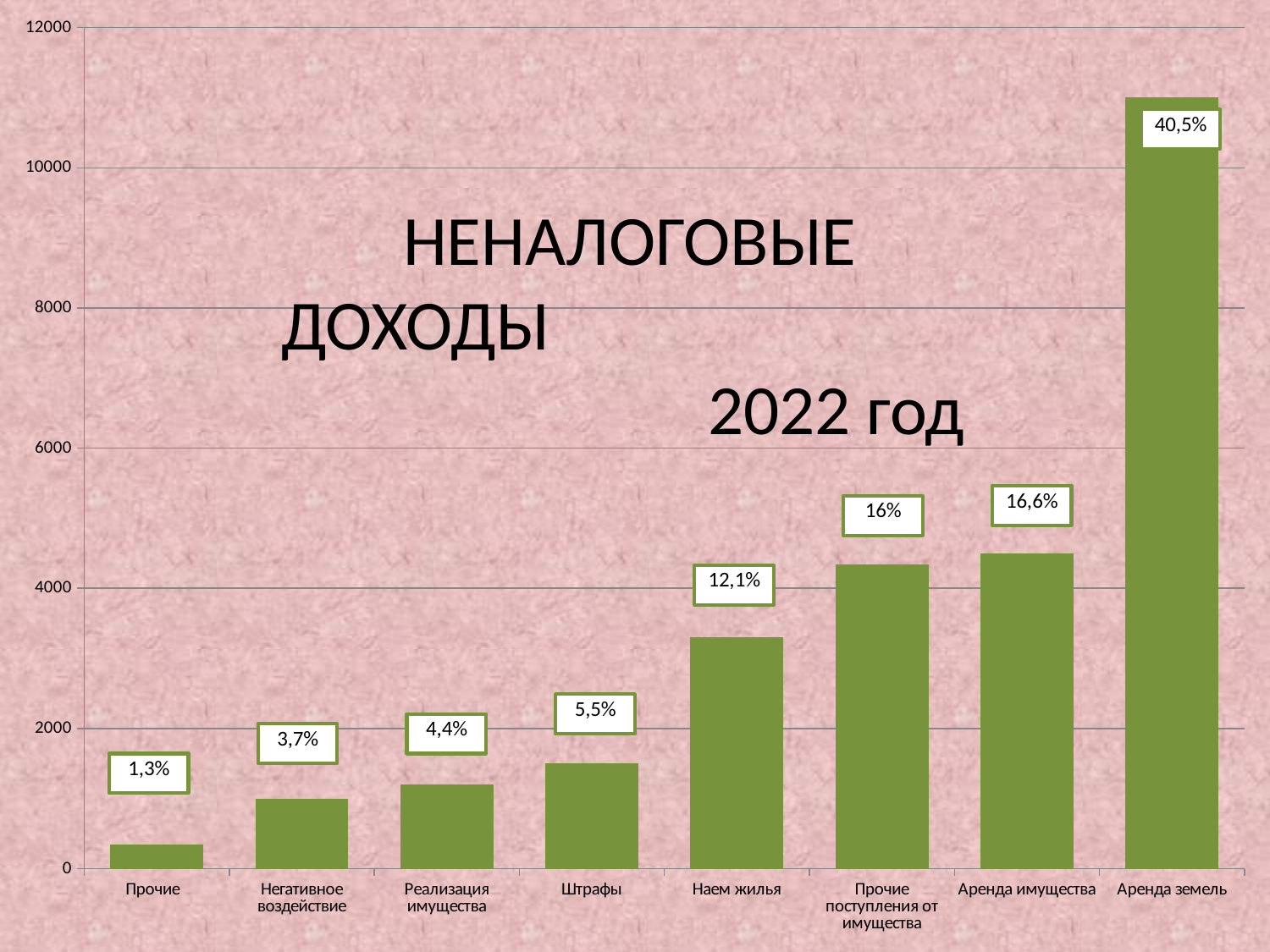
What is the data label shown for Наем жилья? 12,1% What is the difference in percentage points between the labels for Аренда земель and Аренда имущества? 23,9% How many categories are shown on the x axis? 8 What type of chart is shown on the slide? bar chart What is the data label shown for Аренда земель? 40,5% Which category has the highest value? Аренда земель What is the title of the chart? НЕНАЛОГОВЫЕ ДОХОДЫ 2022 год What is the data label shown for Штрафы? 5,5% Which category has the lowest value? Прочие Is the bar for Аренда земель greater or less than 10000 on the vertical axis? greater Which is larger, the value for Наем жилья or the value for Штрафы? Наем жилья What is the data label shown for Прочие поступления от имущества? 16%